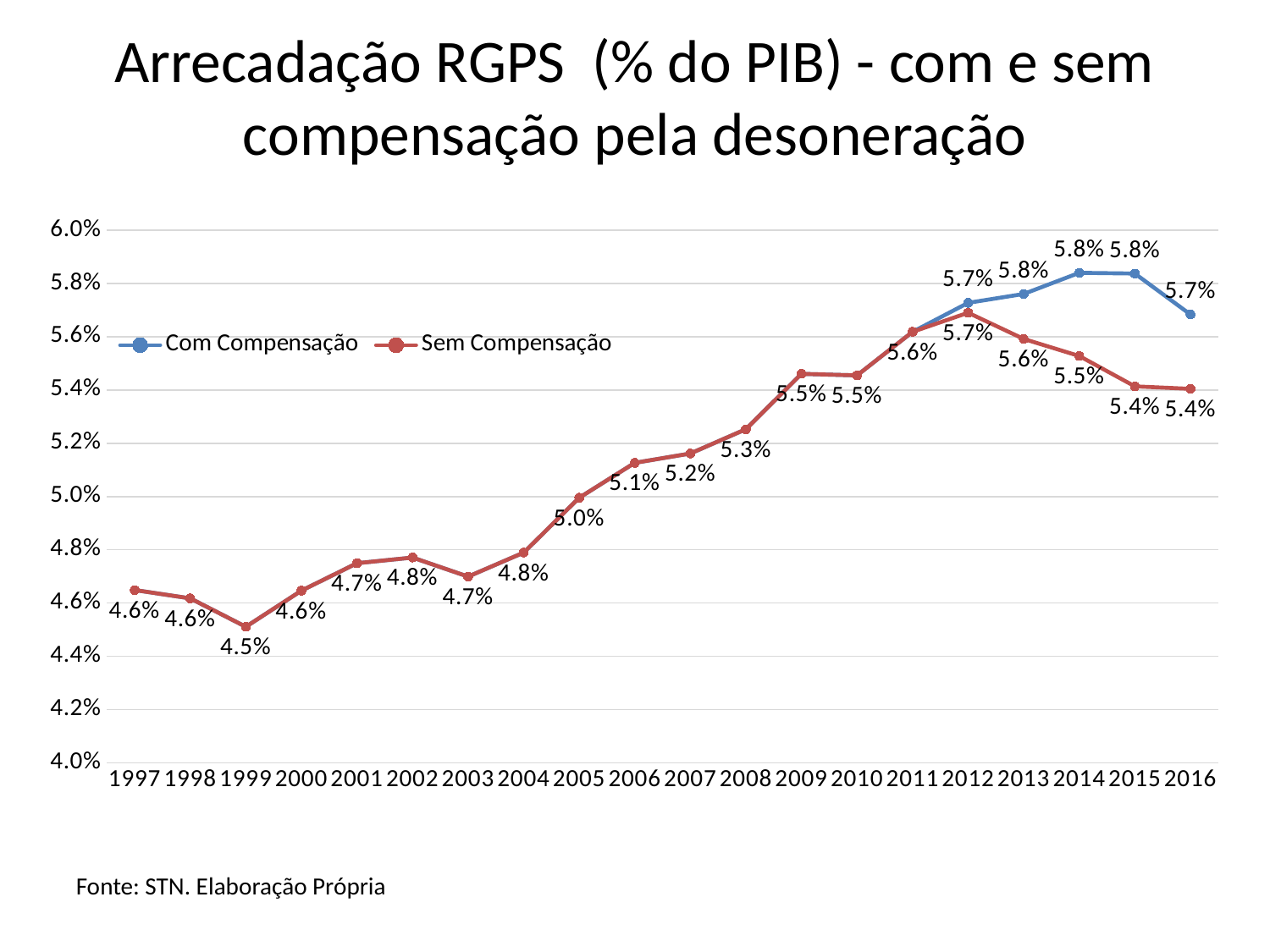
Is the value for 2008 greater or less than 5.2%? greater What is the value for Com Compensação in 2014? 5.8% What is the value for Sem Compensação in 2016? 5.4% What is the difference between Com Compensação and Sem Compensação in 2013? 0.2 percentage points In 2016, which series has the larger value, Com Compensação or Sem Compensação? Com Compensação In which year is the Sem Compensação series at its highest? 2012 What is the value for Sem Compensação in 1999? 4.5% How many years are shown on the x axis? 20 What kind of chart is shown on the slide? line chart In which year is the Sem Compensação series at its lowest? 1999 Does the Sem Compensação series rise or fall from 1999 to 2012? rise How many series does the legend list? 2